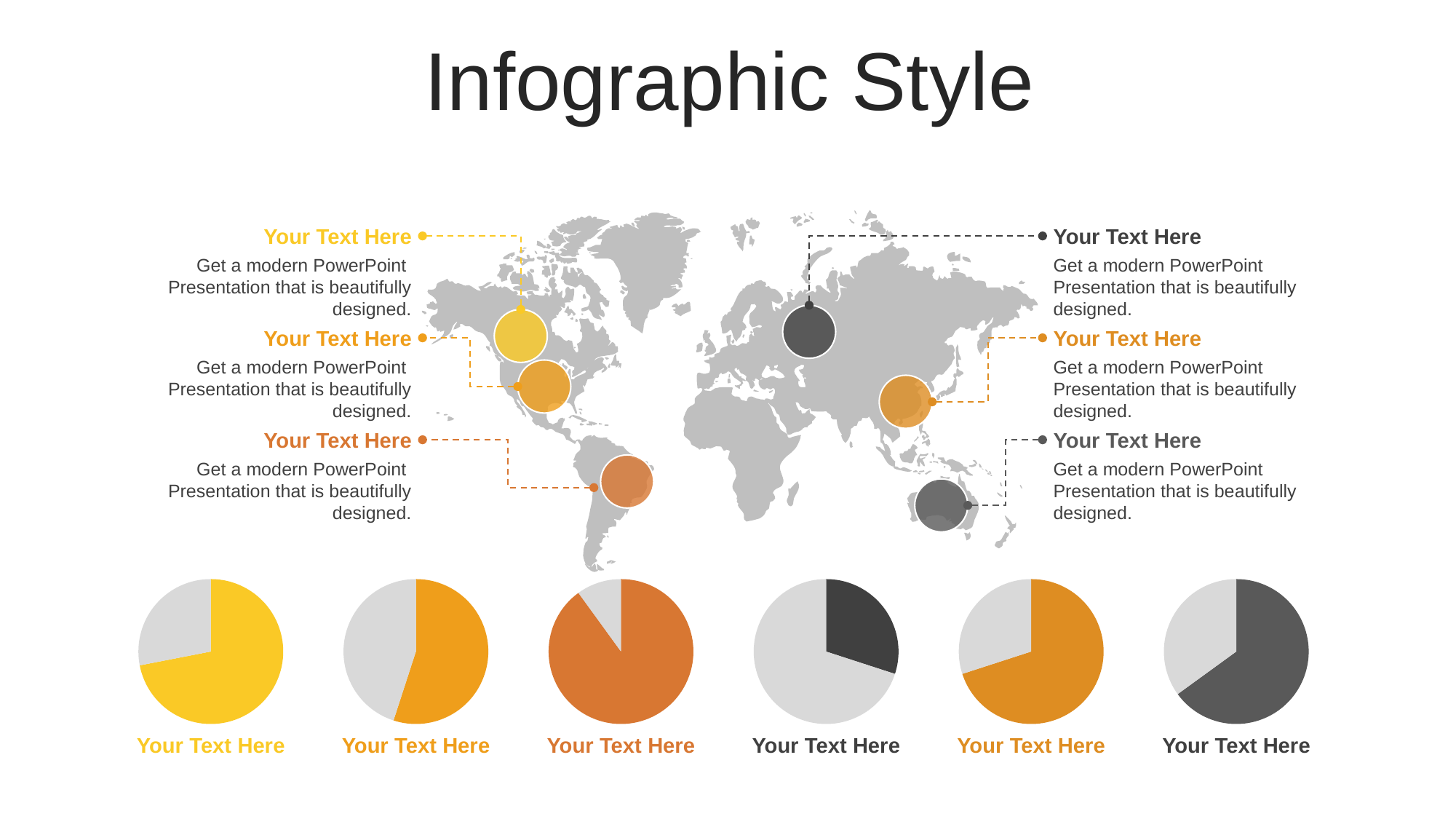
What label appears under each of the pie charts? Your Text Here In the fourth pie chart from the left, which slice is larger, the dark grey slice or the light grey slice? The light grey slice Which of the six pie charts has the smallest coloured (non-grey) slice? The fourth pie chart from the left Which of the six pie charts has the largest coloured (non-grey) slice? The third pie chart from the left In the third pie chart from the left, which slice is larger, the orange slice or the light grey slice? The orange slice What colour is the highlighted slice in the leftmost pie chart? Yellow In the leftmost pie chart, which slice is larger, the yellow slice or the light grey slice? The yellow slice How many pie charts are shown on the slide? 6 How many slices does the leftmost pie chart have? 2 What kind of charts are shown along the bottom of the slide? Pie charts